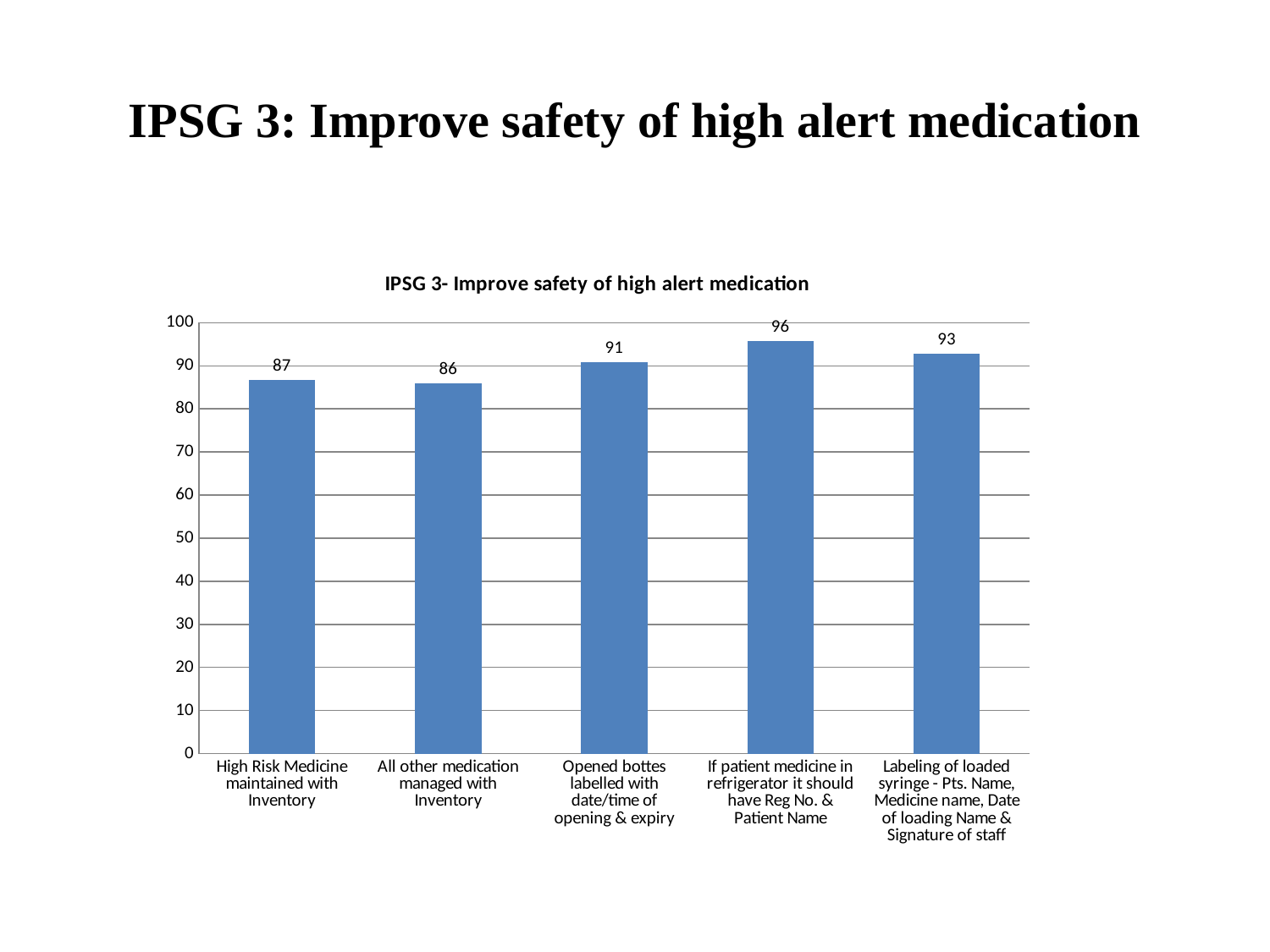
What is the maximum value shown on the y axis? 100 Which is larger: the value for 'Labeling of loaded syringe' or the value for 'Opened bottes labelled with date/time of opening & expiry'? Labeling of loaded syringe Which category has the lowest value? All other medication managed with Inventory What is the value for 'High Risk Medicine maintained with Inventory'? 87 How many categories are shown on the x axis? 5 What is the difference between the values for 'If patient medicine in refrigerator it should have Reg No. & Patient Name' and 'All other medication managed with Inventory'? 10 What is the value for 'If patient medicine in refrigerator it should have Reg No. & Patient Name'? 96 Which category has the highest value? If patient medicine in refrigerator it should have Reg No. & Patient Name What is the value for 'Opened bottes labelled with date/time of opening & expiry'? 91 What kind of chart is shown on the slide? bar chart Is the value for 'All other medication managed with Inventory' greater or less than 90? less What is the title of the chart? IPSG 3- Improve safety of high alert medication